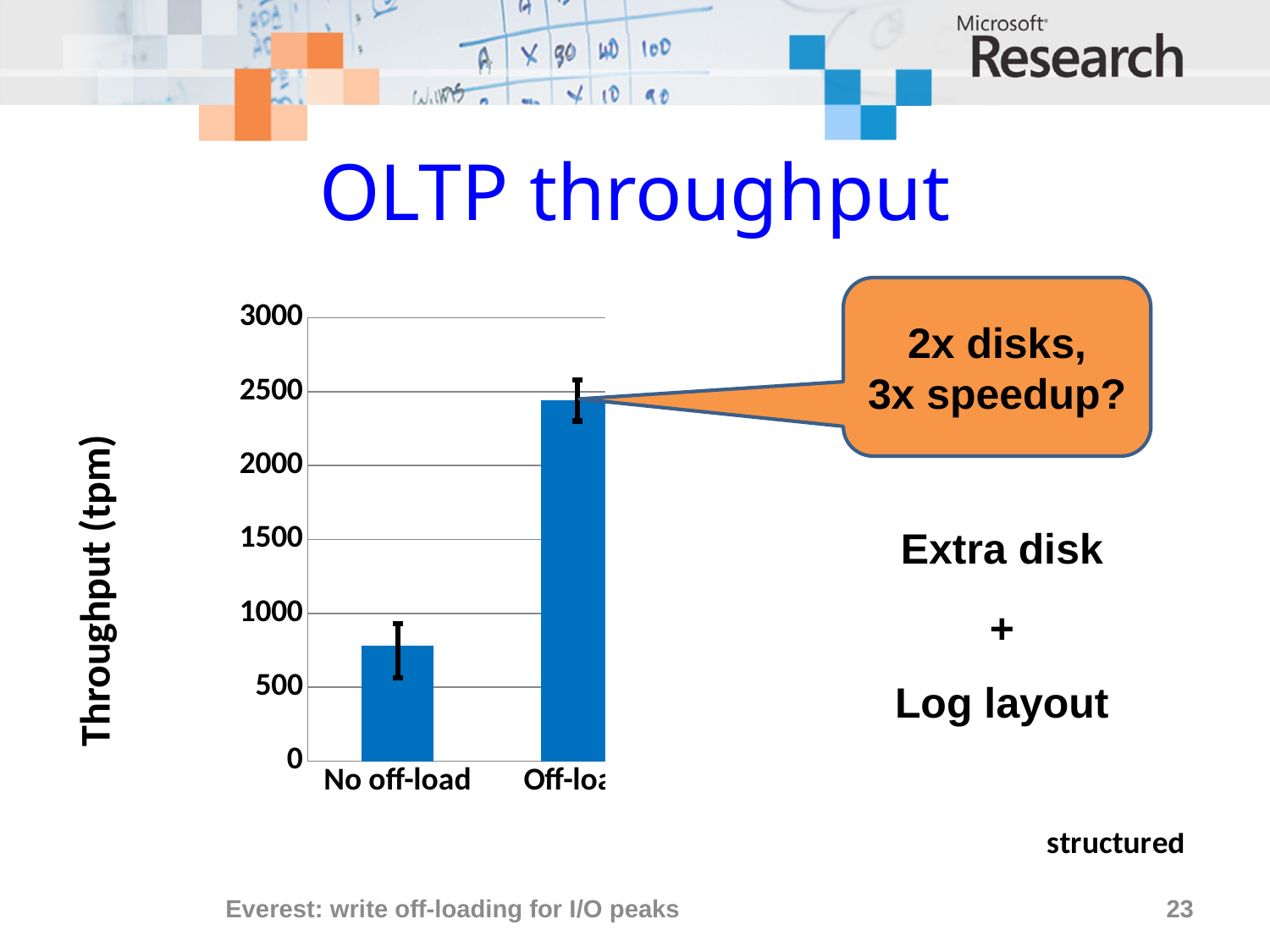
What is the highest value shown on the vertical axis? 3000 What is the label on the vertical axis of the chart? Throughput (tpm) Which is larger, the throughput for No off-load or for Off-load? Off-load What kind of chart is shown on the slide? bar chart How many bars are plotted in the chart? 2 Is the throughput for Off-load greater or less than 3000? less Is the throughput for No off-load greater or less than 500? greater Is the throughput for Off-load greater or less than 2000? greater Do the bar values rise or fall from left to right along the x axis? rise Which category has the lowest throughput? No off-load Which category has the highest throughput? Off-load